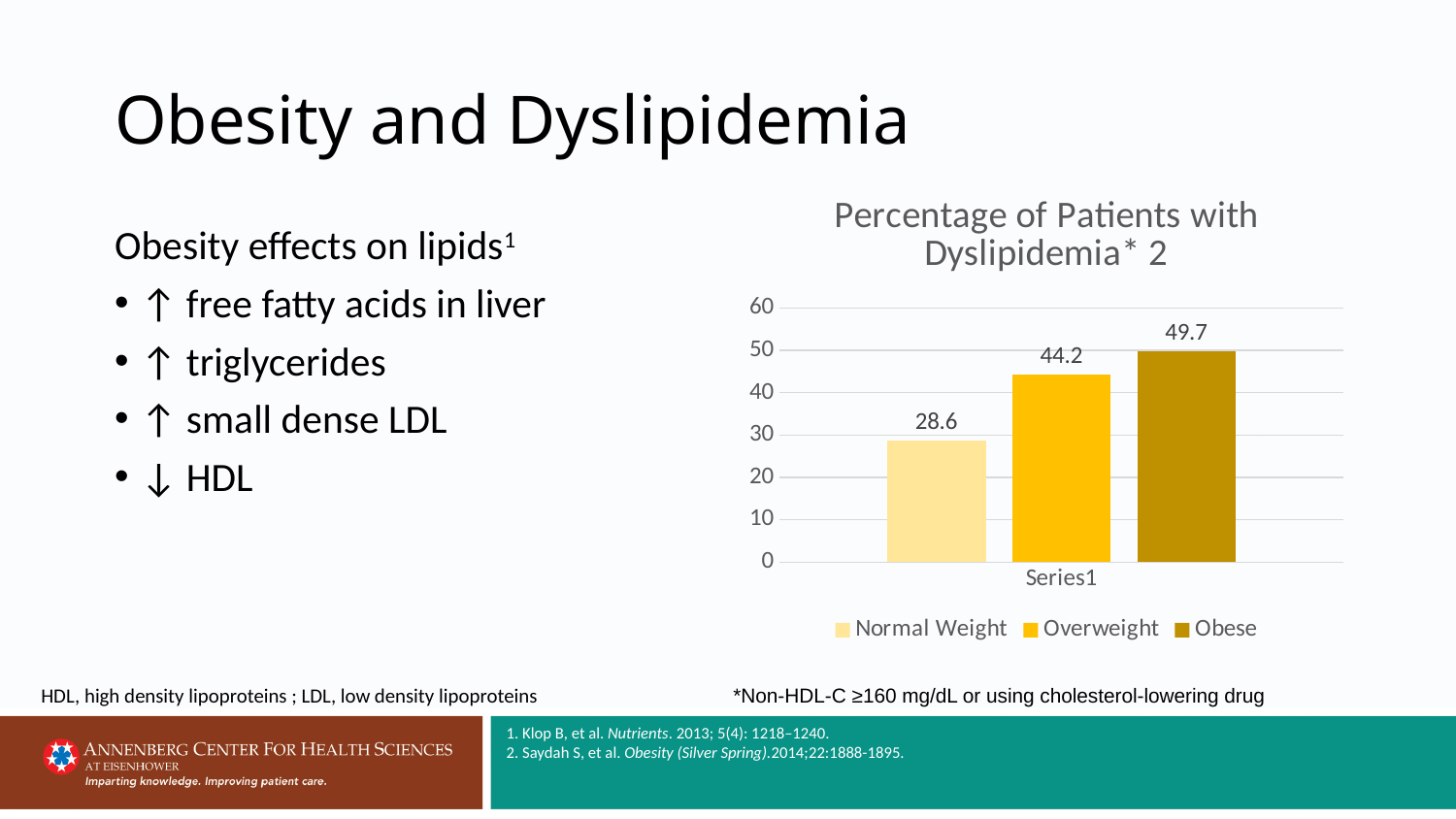
What kind of chart is shown on the slide? bar chart Is the value for Normal Weight greater or less than 30? less What is the difference between the Obese and Normal Weight values? 21.1 What is the title of the chart? Percentage of Patients with Dyslipidemia* 2 What is the value for Obese in the chart? 49.7 How many series does the legend list? 3 What is the value for Normal Weight in the chart? 28.6 Which group has the highest percentage of patients with dyslipidemia? Obese Which group has the lowest percentage of patients with dyslipidemia? Normal Weight What is the value for Overweight in the chart? 44.2 Which is larger, the value for Overweight or the value for Obese? Obese What is the difference between the Overweight and Normal Weight values? 15.6